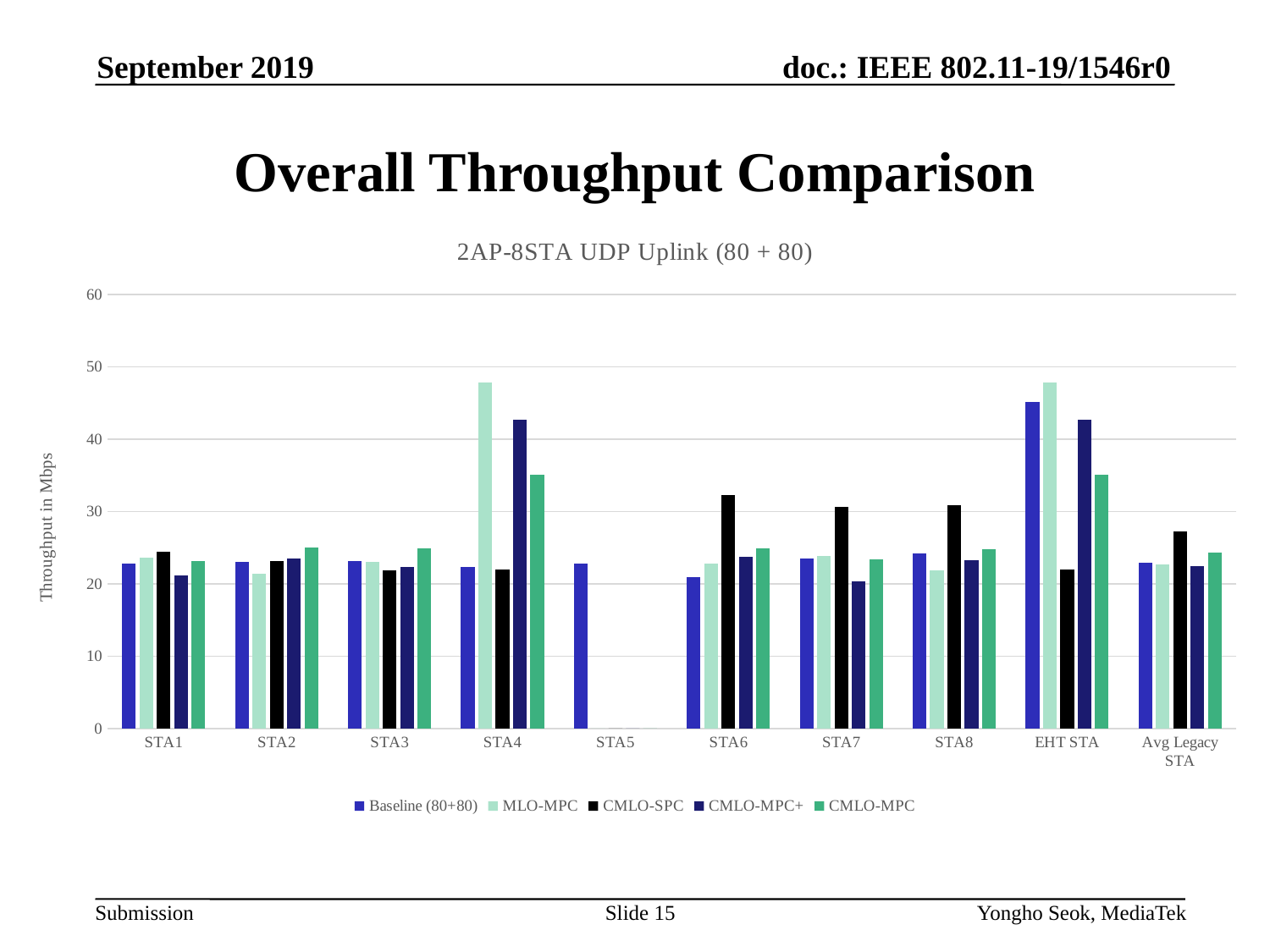
What kind of chart is shown on the slide? bar chart Which series has the highest value for STA4? MLO-MPC Is the MLO-MPC value for STA4 greater or less than 40? greater Is the CMLO-SPC value for STA6 greater or less than 30? greater Which series has the lowest value for EHT STA? CMLO-SPC Is the CMLO-SPC value for EHT STA greater or less than 30? less How many series does the chart's legend list? 5 What is the title of the chart? 2AP-8STA UDP Uplink (80 + 80) For STA6, which is larger: the CMLO-SPC value or the Baseline (80+80) value? CMLO-SPC How many categories are shown along the x axis of the chart? 10 What is the label on the chart's vertical axis? Throughput in Mbps